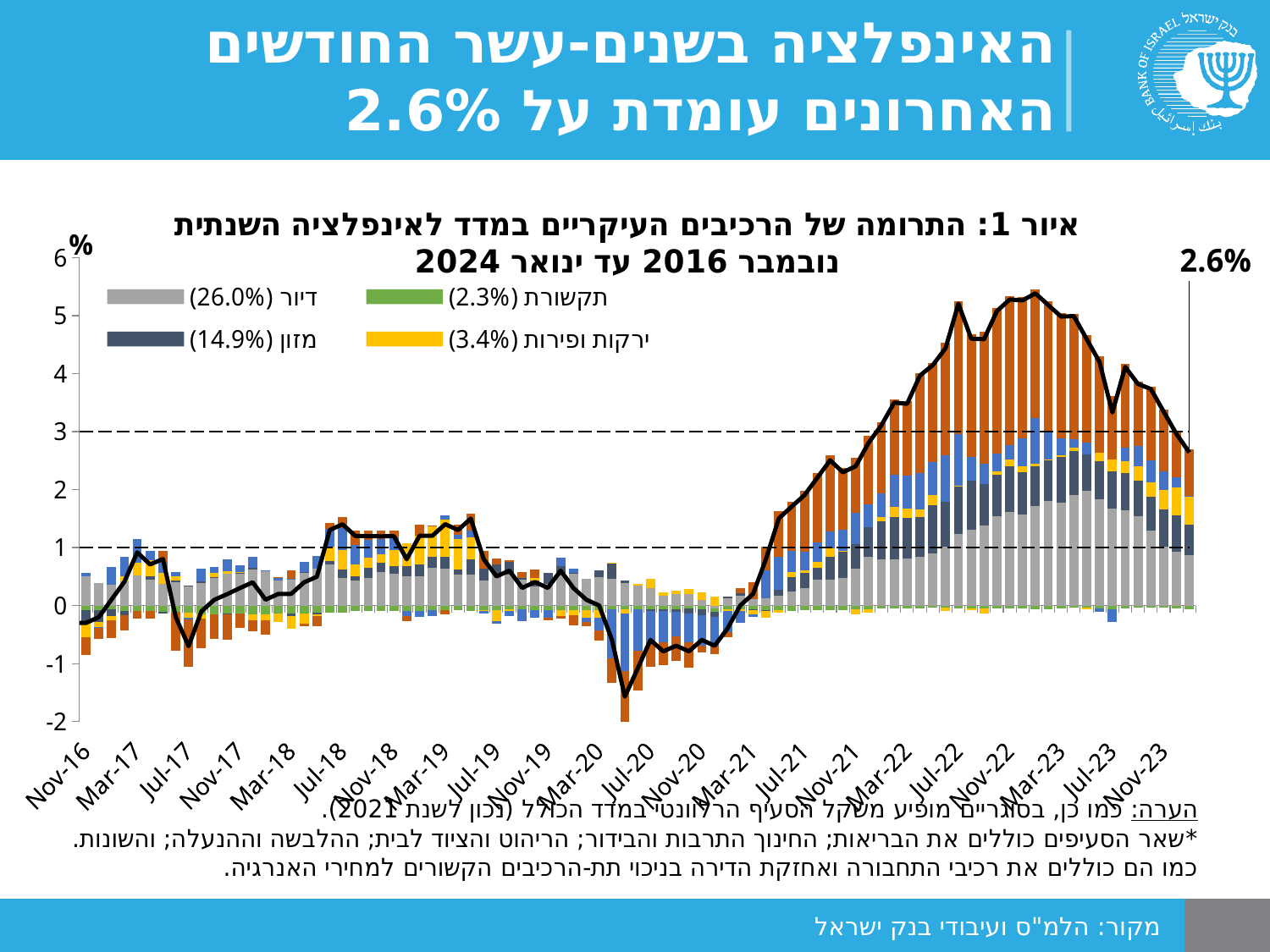
Does the inflation line rise or fall between Mar-21 and Jan-23? rise What weight is shown in the legend next to מזון (food)? 14.9% Is the value of the inflation line at Jul-22 greater or less than 4? greater Is the value of the inflation line at Jul-20 greater or less than -1? greater How many date labels are shown on the x axis? 22 How many series are listed in the visible legend of the chart? 4 Which is larger, the inflation line value at Nov-21 or at Nov-19? Nov-21 What is the value of the annual inflation line at the end of the series (January 2024), as labelled on the chart? 2.6% Is the value of the inflation line at Nov-21 greater or less than 2? greater What weight is shown in the legend next to דיור (housing)? 26.0% What kind of chart is shown on the slide? bar chart (stacked bars with a line)